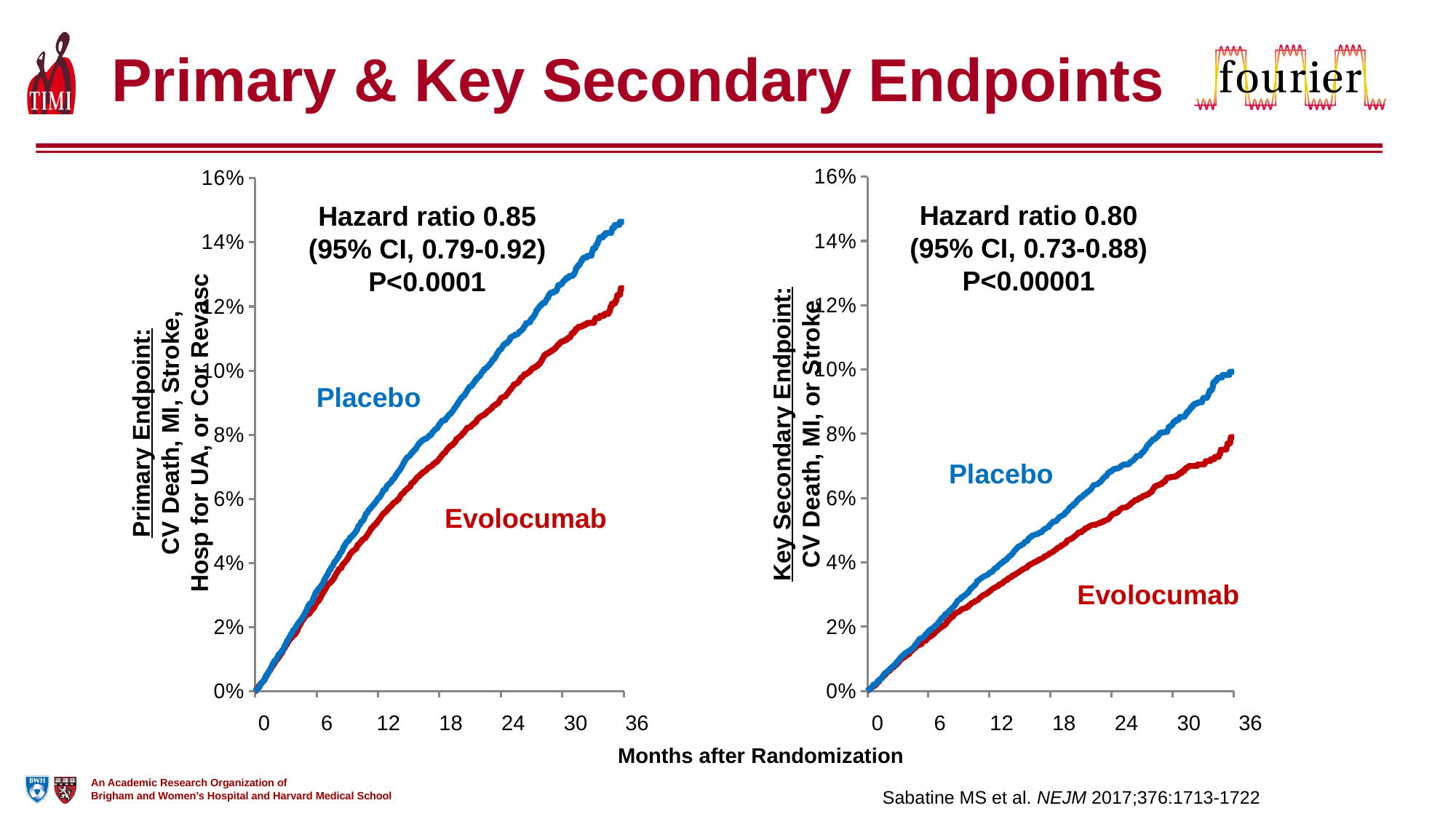
On the right chart (Key Secondary Endpoint), is the Placebo value at 18 months greater or less than 6%? less On the left chart (Primary Endpoint), which series is higher at 36 months, Placebo or Evolocumab? Placebo On the left chart (Primary Endpoint), is the Placebo value at the end of follow-up greater or less than 14%? greater How many series are plotted on the right chart (Key Secondary Endpoint)? 2 On the right chart (Key Secondary Endpoint), is the Placebo value at the end of follow-up greater or less than 8%? greater What is the shared x-axis label for both charts? Months after Randomization What kind of chart is the left chart (Primary Endpoint)? Line chart What hazard ratio is shown on the left chart (Primary Endpoint)? 0.85 On the left chart (Primary Endpoint), do the event rates rise or fall as months after randomization increase? Rise On the right chart (Key Secondary Endpoint), which series is lower at 30 months, Placebo or Evolocumab? Evolocumab